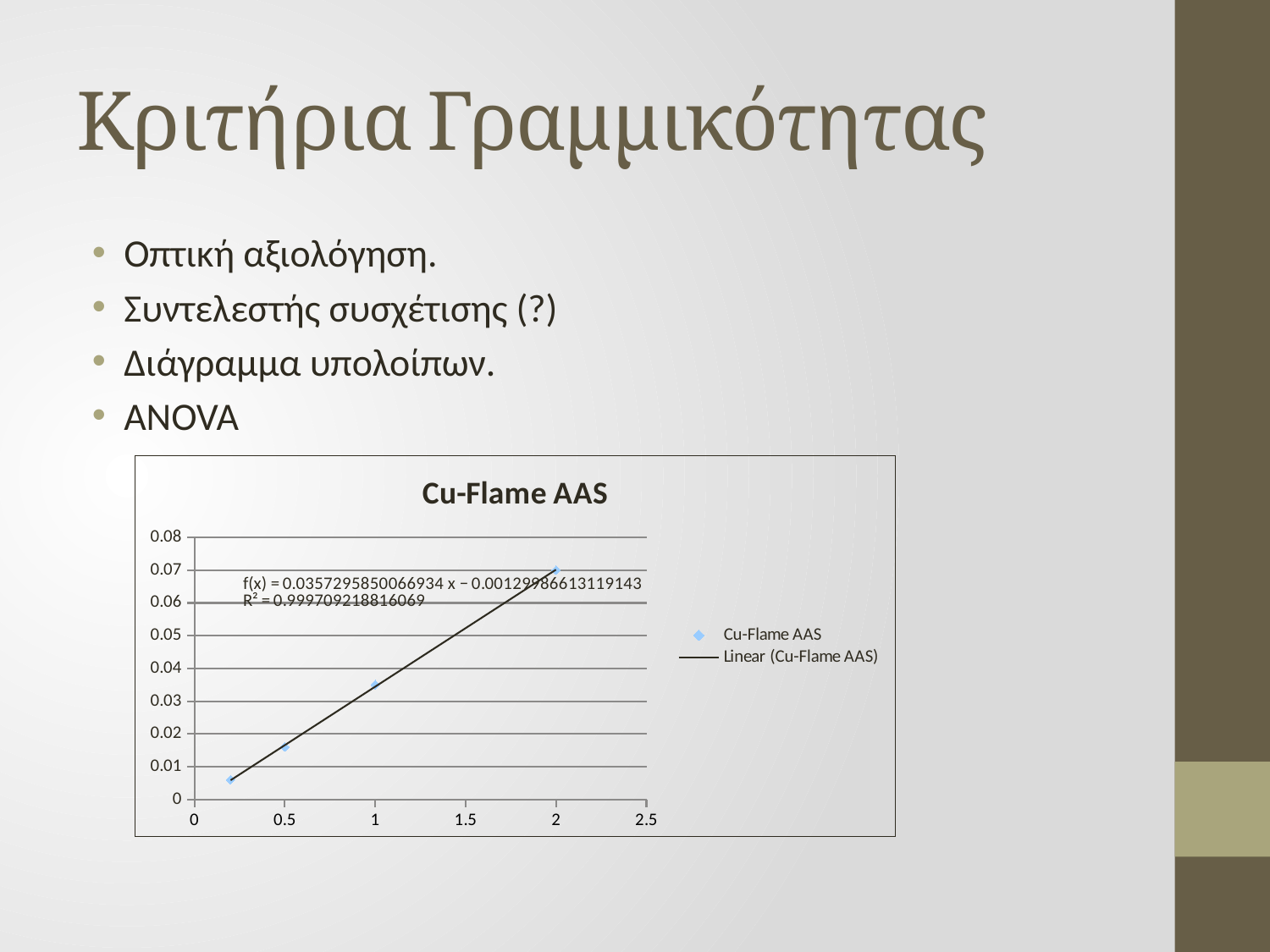
Is the value of the point at x = 0.5 greater or less than 0.02? less How many data points are plotted in the Cu-Flame AAS chart? 4 What is the title of the chart? Cu-Flame AAS Do the plotted values rise or fall as x increases along the x axis? rise Which point has the larger value, the one at x = 1 or the one at x = 2? x = 2 What R² value is printed on the chart? 0.999709218816069 Is the value of the point at x = 1 greater or less than 0.03? greater Is the value of the point at x = 2 greater or less than 0.06? greater At which x value is the highest plotted point? 2 What kind of chart is shown on the slide? scatter chart with a linear trendline How many entries does the legend of the chart list? 2